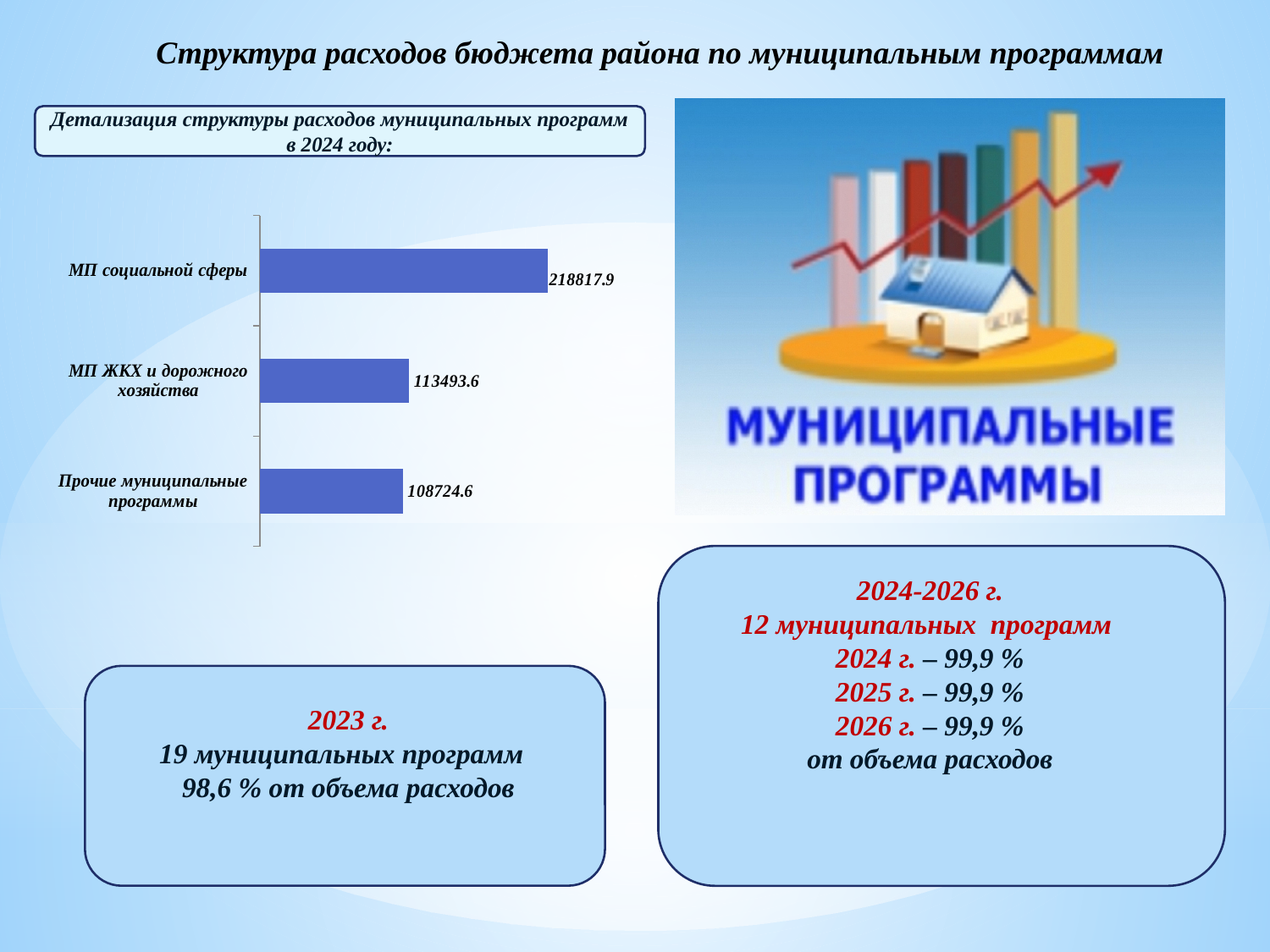
Which category has the lowest value? Прочие муниципальные программы What is the difference between the values for МП ЖКХ и дорожного хозяйства and Прочие муниципальные программы? 4769.0 Which is larger, the value for МП социальной сферы or the value for Прочие муниципальные программы? МП социальной сферы What is the value for МП социальной сферы? 218817.9 What is the title of the chart? Детализация структуры расходов муниципальных программ в 2024 году: Which category has the highest value? МП социальной сферы What is the value for Прочие муниципальные программы? 108724.6 What is the difference between the values for МП социальной сферы and МП ЖКХ и дорожного хозяйства? 105324.3 What colour are the bars in the chart? Blue How many categories are shown in the chart? 3 What is the value for МП ЖКХ и дорожного хозяйства? 113493.6 What kind of chart is shown on the slide? Bar chart